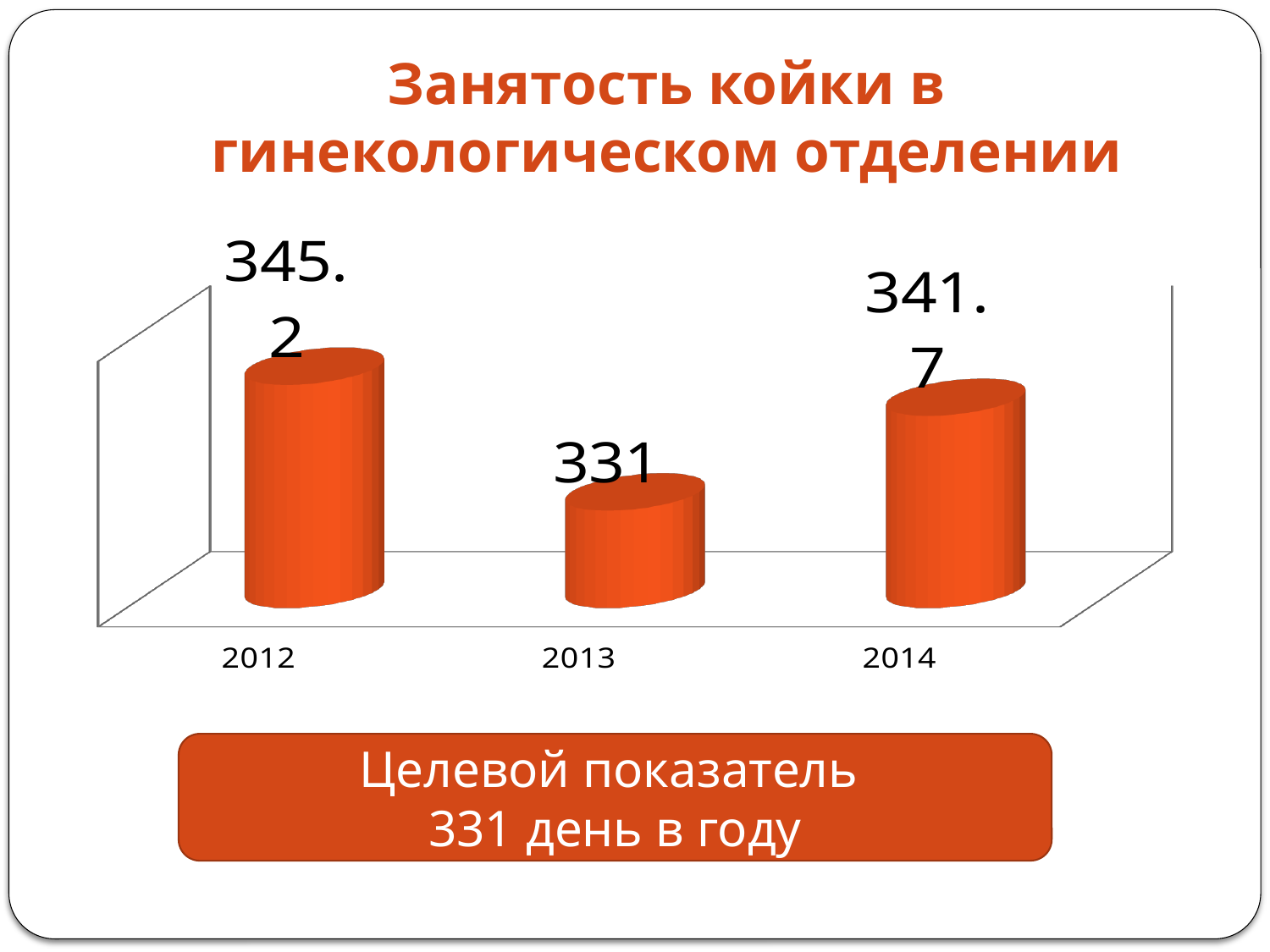
What is the value for 2014? 341.7 What target value (целевой показатель) is stated on the slide? 331 день в году What is the value for 2012? 345.2 What is the title of the chart? Занятость койки в гинекологическом отделении What is the value for 2013? 331 Which year has the highest value? 2012 Which is larger, the value for 2013 or the value for 2014? 2014 How many years are shown on the chart? 3 Which year has the lowest value? 2013 What kind of chart is shown on the slide? bar chart What is the difference between the values for 2012 and 2013? 14.2 What is the difference between the values for 2012 and 2014? 3.5